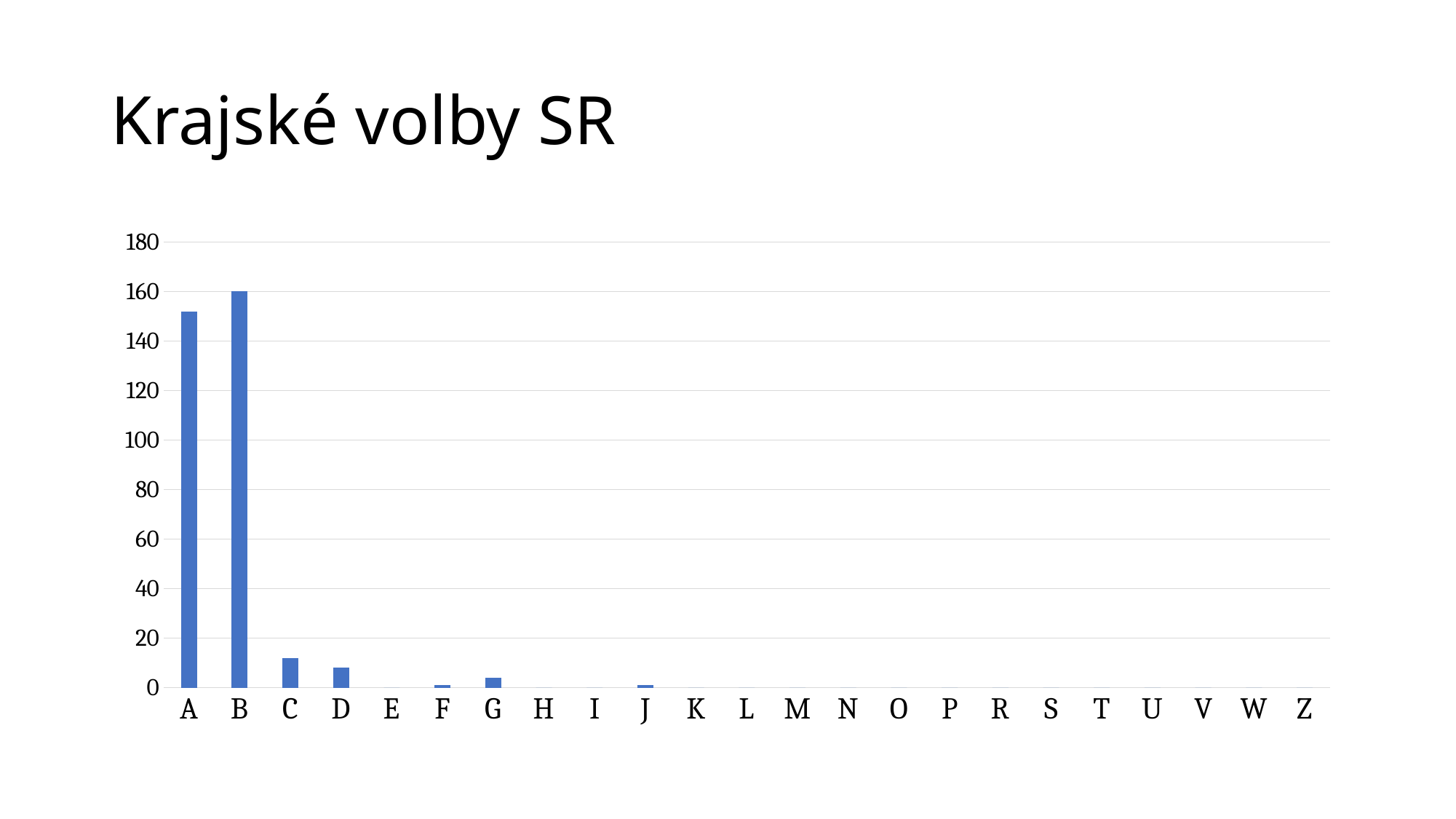
What is the title of the chart? Krajské volby SR Is the value for C greater or less than 20? less Is the value for B greater or less than 100? greater What kind of chart is shown on the slide? bar chart Is the value for A greater or less than 160? less Which category has the highest value? B What is the value for category B? 160 Which is larger, the value for C or the value for D? C Which is larger, the value for A or the value for B? B How many categories are shown on the x axis? 23